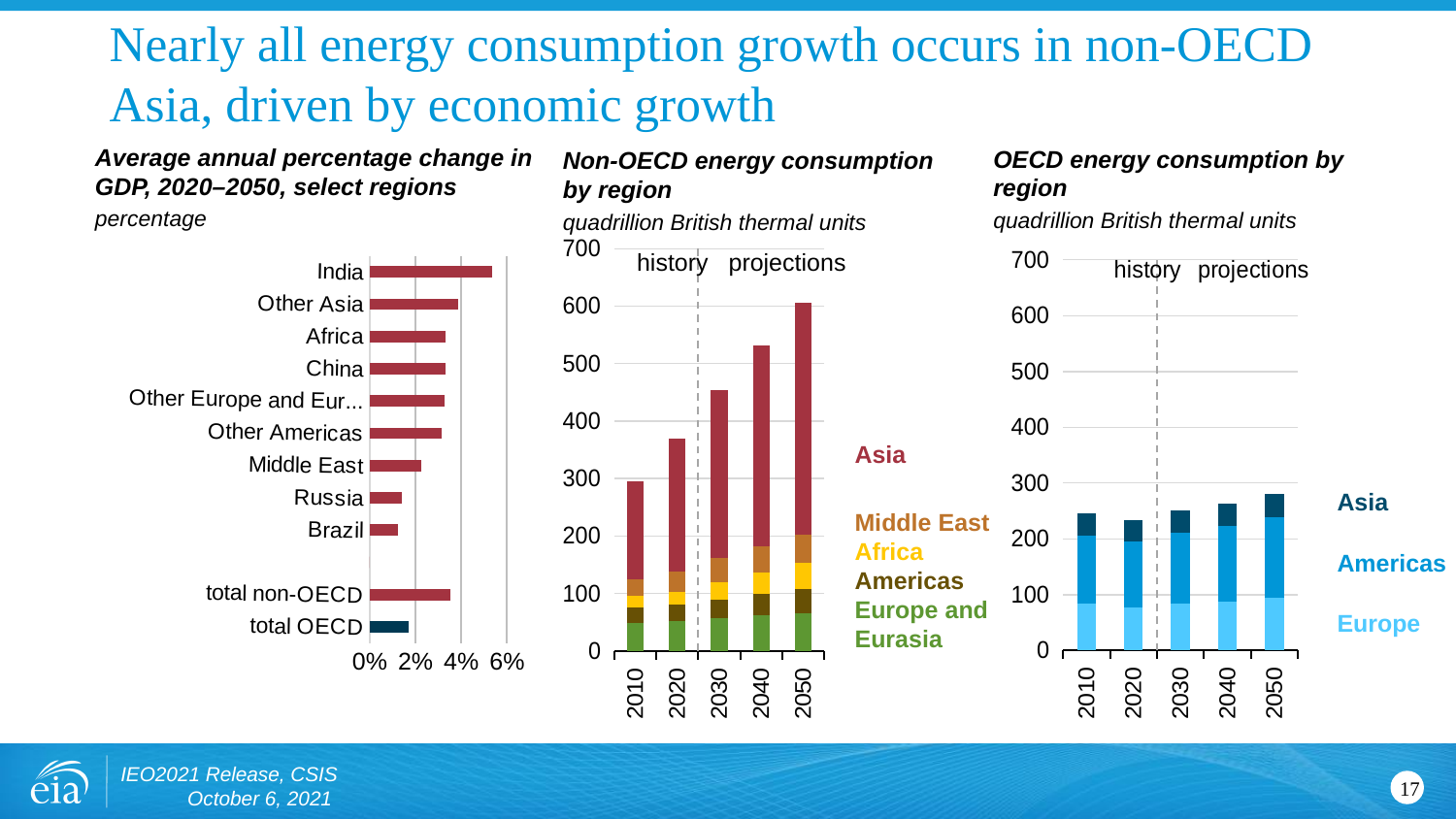
In the 'Average annual percentage change in GDP, 2020–2050, select regions' chart, which region has the highest value? India How many series does the legend list in the 'OECD energy consumption by region' chart? 3 In the 'Non-OECD energy consumption by region' chart, do the stacked totals rise or fall from 2010 to 2050? rise What kind of chart is the 'Average annual percentage change in GDP, 2020–2050, select regions' chart? bar chart In the 'Average annual percentage change in GDP, 2020–2050, select regions' chart, is the value for India greater or less than 4%? greater How many years are plotted on the x axis of the 'Non-OECD energy consumption by region' chart? 5 In the 'Average annual percentage change in GDP, 2020–2050, select regions' chart, which is larger, India or Brazil? India How many categories are shown in the 'Average annual percentage change in GDP, 2020–2050, select regions' chart? 11 In the 'OECD energy consumption by region' chart, is the total for 2050 greater or less than 300? less In the 'Non-OECD energy consumption by region' chart, is the total for 2050 greater or less than 500? greater How many series does the legend list in the 'Non-OECD energy consumption by region' chart? 5